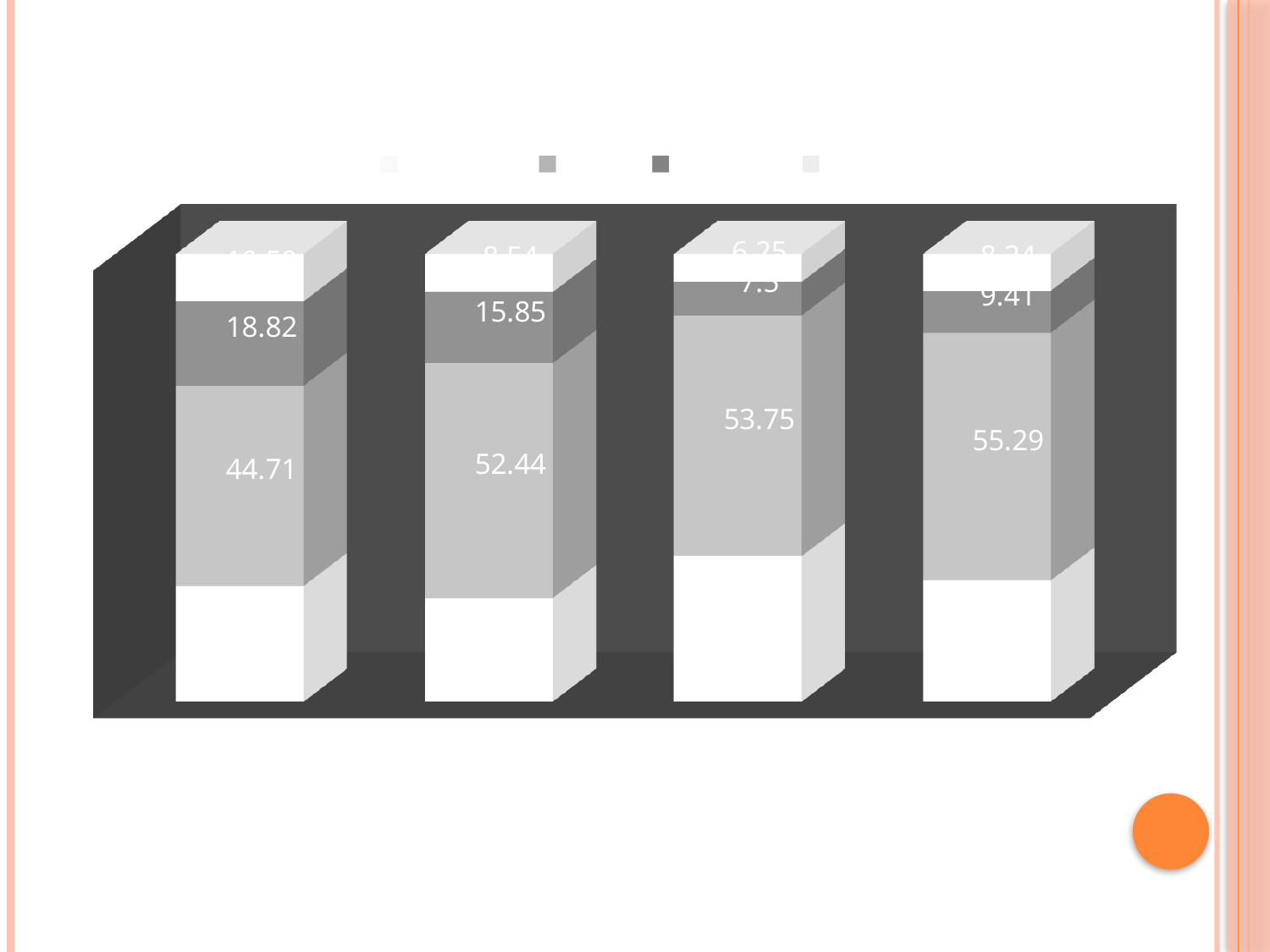
What is the value of the dark-grey segment in the third bar from the left? 7.5 Which is larger: the light-grey segment of the second bar or the light-grey segment of the third bar? the third bar (53.75) What is the difference between the light-grey segment values of the fourth bar (55.29) and the first bar (44.71)? 10.58 Do the values of the large light-grey segments rise or fall from the leftmost bar to the rightmost bar? rise Which bar has the lowest value for the dark-grey segment? the third bar from the left (7.5) How many bars does the chart contain? 4 Which bar has the highest value for the large light-grey segment? the fourth bar from the left (55.29) How many series does the legend above the chart list? 4 What is the value of the large light-grey segment in the fourth bar from the left? 55.29 What is the value of the dark-grey segment in the second bar from the left? 15.85 What kind of chart is shown on the slide? stacked bar chart What is the value of the large light-grey segment in the first bar from the left? 44.71